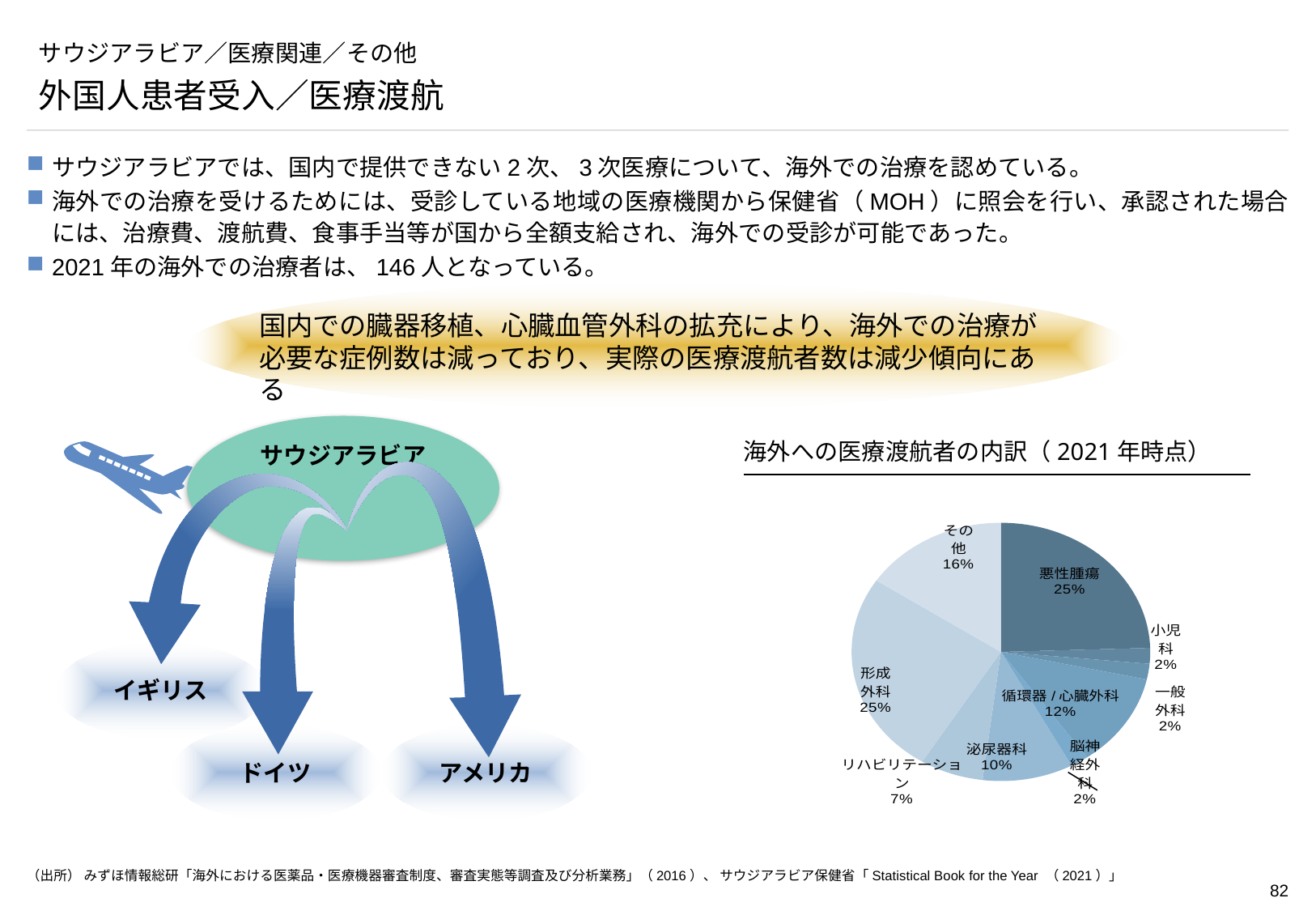
What year does the title of the pie chart 海外への医療渡航者の内訳 say the data is as of? 2021年 How many slices (categories) does the pie chart 海外への医療渡航者の内訳 have? 9 What type of chart is shown under the title 海外への医療渡航者の内訳（2021年時点）? pie chart In the pie chart 海外への医療渡航者の内訳, what share is labelled for 形成外科? 25% In the pie chart 海外への医療渡航者の内訳, what share is labelled for その他? 16% In the pie chart 海外への医療渡航者の内訳, what share is labelled for リハビリテーション? 7% In the pie chart 海外への医療渡航者の内訳, what share is labelled for 泌尿器科? 10% In the pie chart 海外への医療渡航者の内訳, which is larger: 循環器/心臓外科 or 泌尿器科? 循環器/心臓外科 In the pie chart 海外への医療渡航者の内訳, what share is labelled for 循環器/心臓外科? 12% In the pie chart 海外への医療渡航者の内訳, what share is labelled for 悪性腫瘍? 25% In the pie chart 海外への医療渡航者の内訳, what share is labelled for 小児科? 2% In the pie chart 海外への医療渡航者の内訳, what is the difference in percentage points between 悪性腫瘍 and その他? 9 percentage points